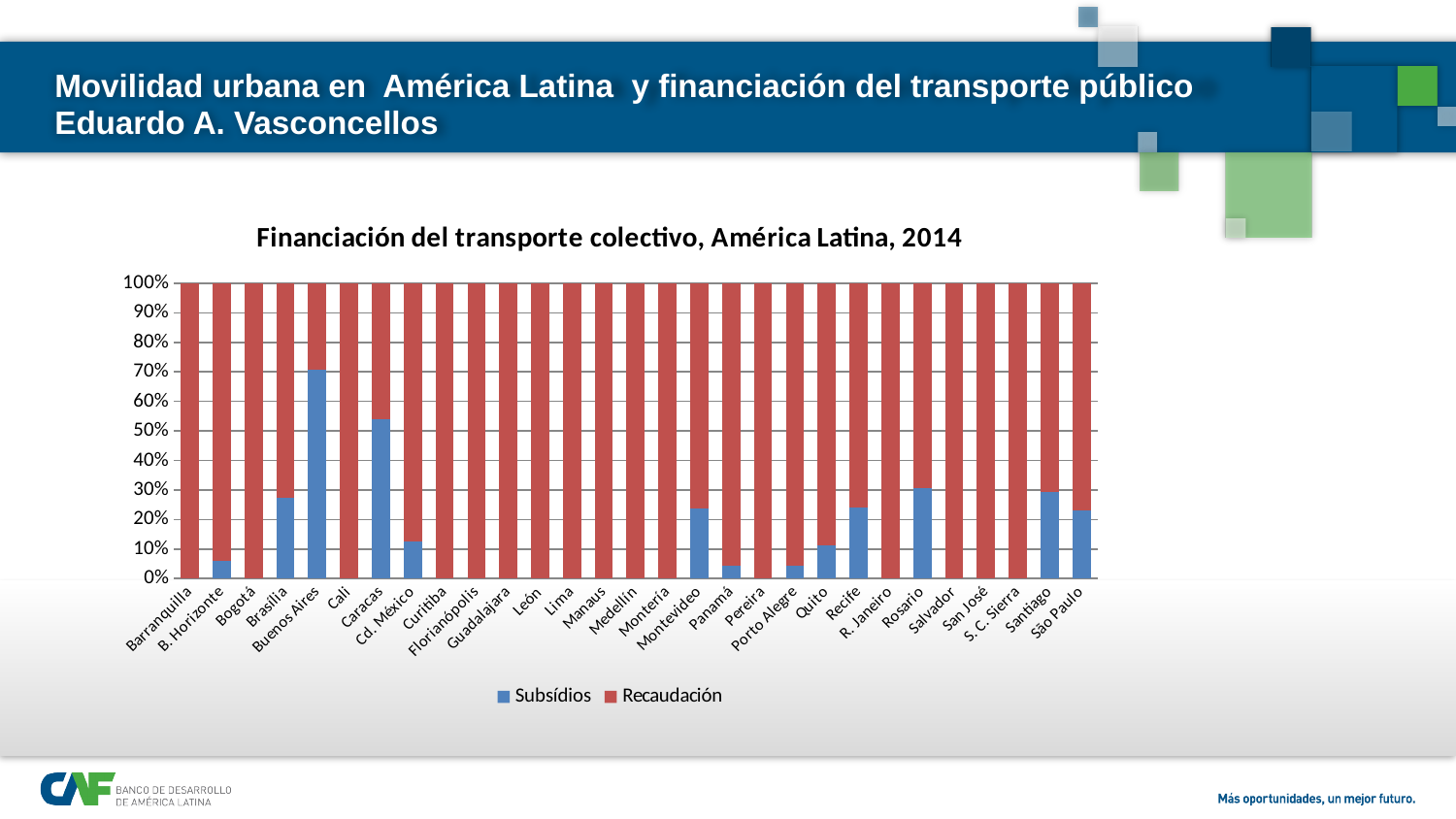
What is the total of the stacked bar for Lima? 100% What is the title of the chart? Financiación del transporte colectivo, América Latina, 2014 Is the Subsídios share for Caracas greater or less than 40%? greater What kind of chart is shown on the slide? Stacked bar chart Which city has the highest share of Subsídios? Buenos Aires How many series does the chart legend list? 2 What are the two series named in the legend? Subsídios and Recaudación Is the Subsídios share for Buenos Aires greater or less than 60%? greater Is the Subsídios share for Panamá greater or less than 10%? less How many cities are shown on the x axis of the chart? 29 Which city has a larger Subsídios share, Buenos Aires or Caracas? Buenos Aires